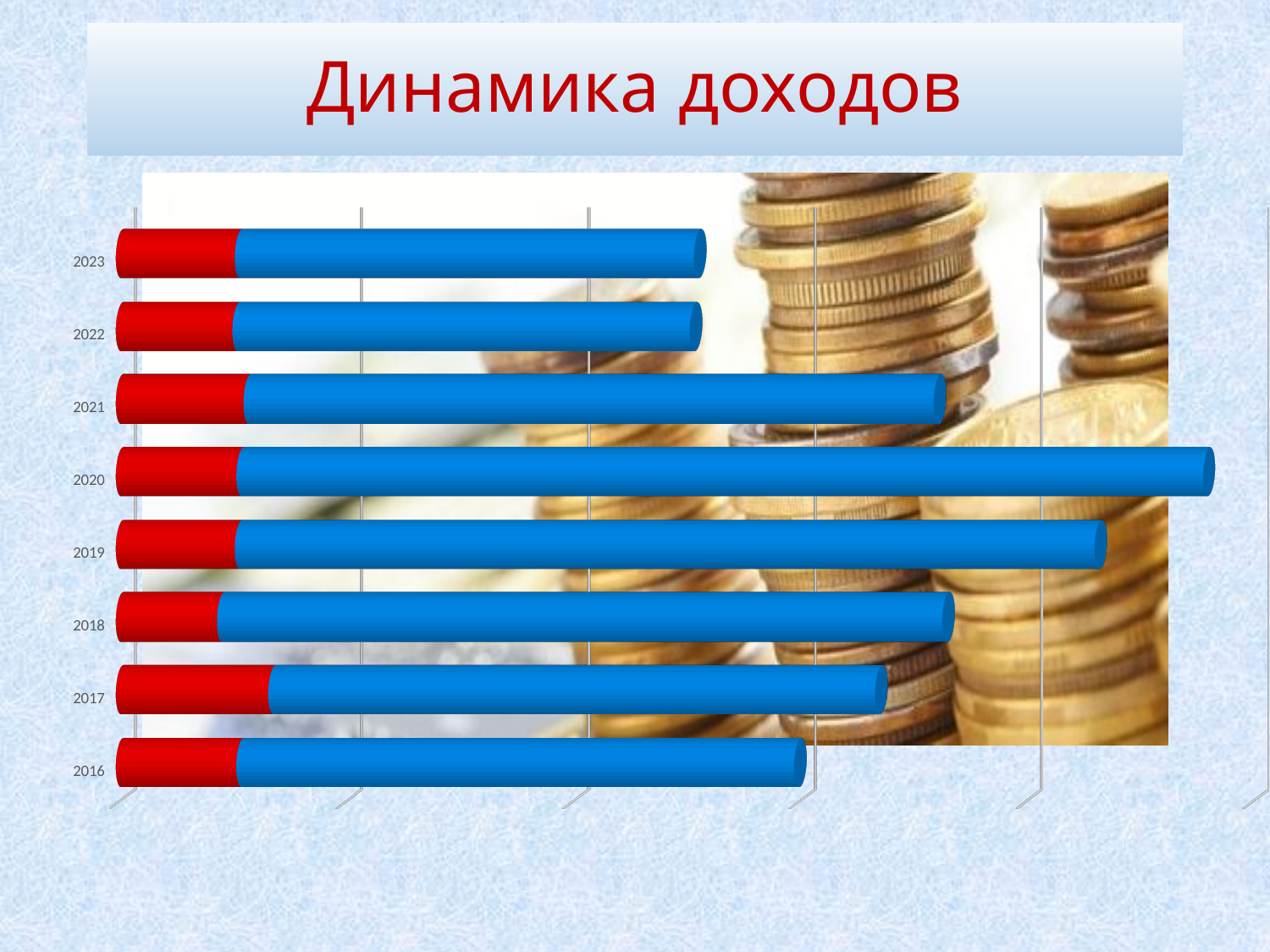
Which bar is longer in total, 2020 or 2016? 2020 Which year has the longest red segment? 2017 Which bar is longer in total, 2019 or 2021? 2019 Which bar is longer in total, 2019 or 2023? 2019 How many years (categories) are shown on the chart? 8 What is the title of the slide with the chart? Динамика доходов Which year has the longest total bar on the chart? 2020 Which year is listed at the top of the chart? 2023 What kind of chart is shown on the slide? bar chart How many coloured segments does each bar consist of? 2 Which year is listed at the bottom of the chart? 2016